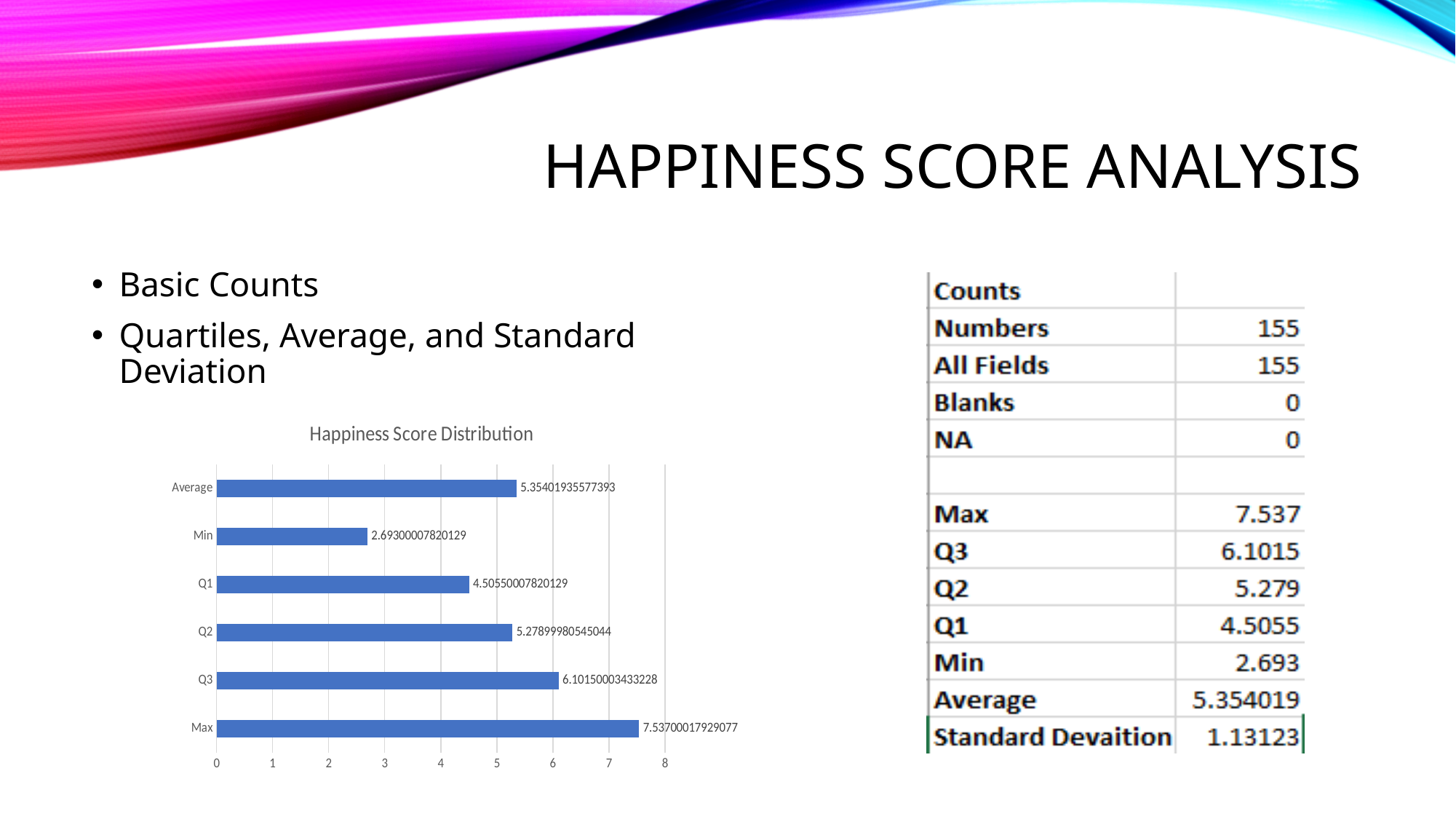
What is the difference between the Q3 and Q1 values in the chart? 1.59599995613099 What is the value shown for Average in the chart? 5.35401935577393 What is the value of the Min bar in the Happiness Score Distribution chart? 2.69300007820129 Which is larger in the chart, the Average bar or the Q2 bar? Average What type of chart is shown on the slide? bar chart How many categories are plotted in the Happiness Score Distribution chart? 6 What is the value of the Max bar in the Happiness Score Distribution chart? 7.53700017929077 What is the title of the chart? Happiness Score Distribution What is the value shown for Q1 in the chart? 4.50550007820129 Which category has the lowest value in the Happiness Score Distribution chart? Min Which category has the highest value in the Happiness Score Distribution chart? Max Is the value for Max in the chart greater or less than 7? greater